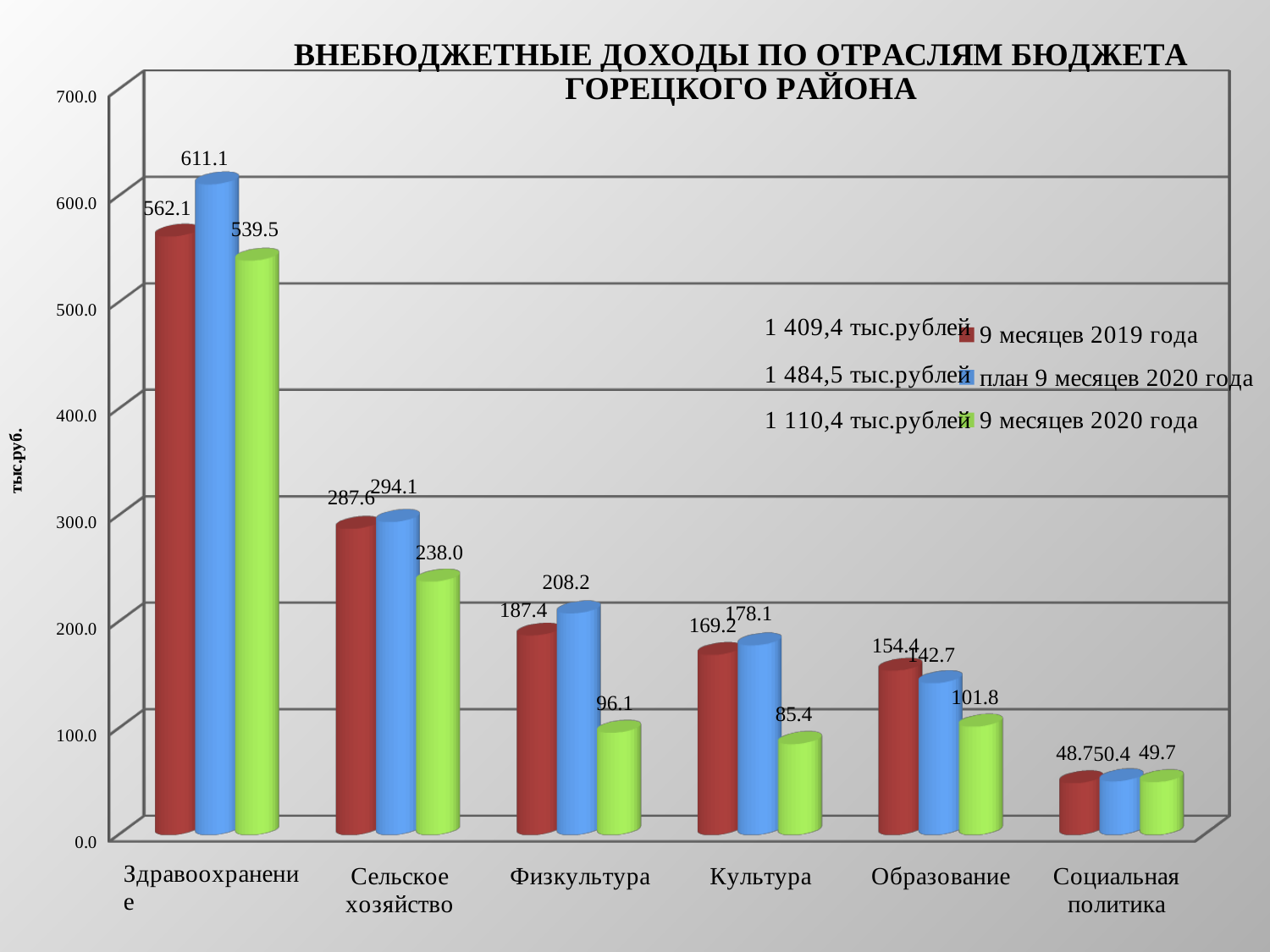
Is the value for Культура in the series '9 месяцев 2020 года' greater or less than 100.0? less What kind of chart is shown on the slide? bar chart What is the difference between the 'план 9 месяцев 2020 года' and '9 месяцев 2020 года' values for Сельское хозяйство? 56.1 What is the value for Здравоохранение in the series 'план 9 месяцев 2020 года'? 611.1 For Образование, which is larger: the '9 месяцев 2019 года' value or the 'план 9 месяцев 2020 года' value? 9 месяцев 2019 года What is the value for Образование in the series '9 месяцев 2019 года'? 154.4 How many categories are shown on the x axis? 6 How many series does the legend list? 3 What is the unit label on the vertical axis? тыс.руб. What is the value for Физкультура in the series '9 месяцев 2020 года'? 96.1 Which category has the highest value in the series '9 месяцев 2019 года'? Здравоохранение Which category has the lowest value in the series 'план 9 месяцев 2020 года'? Социальная политика